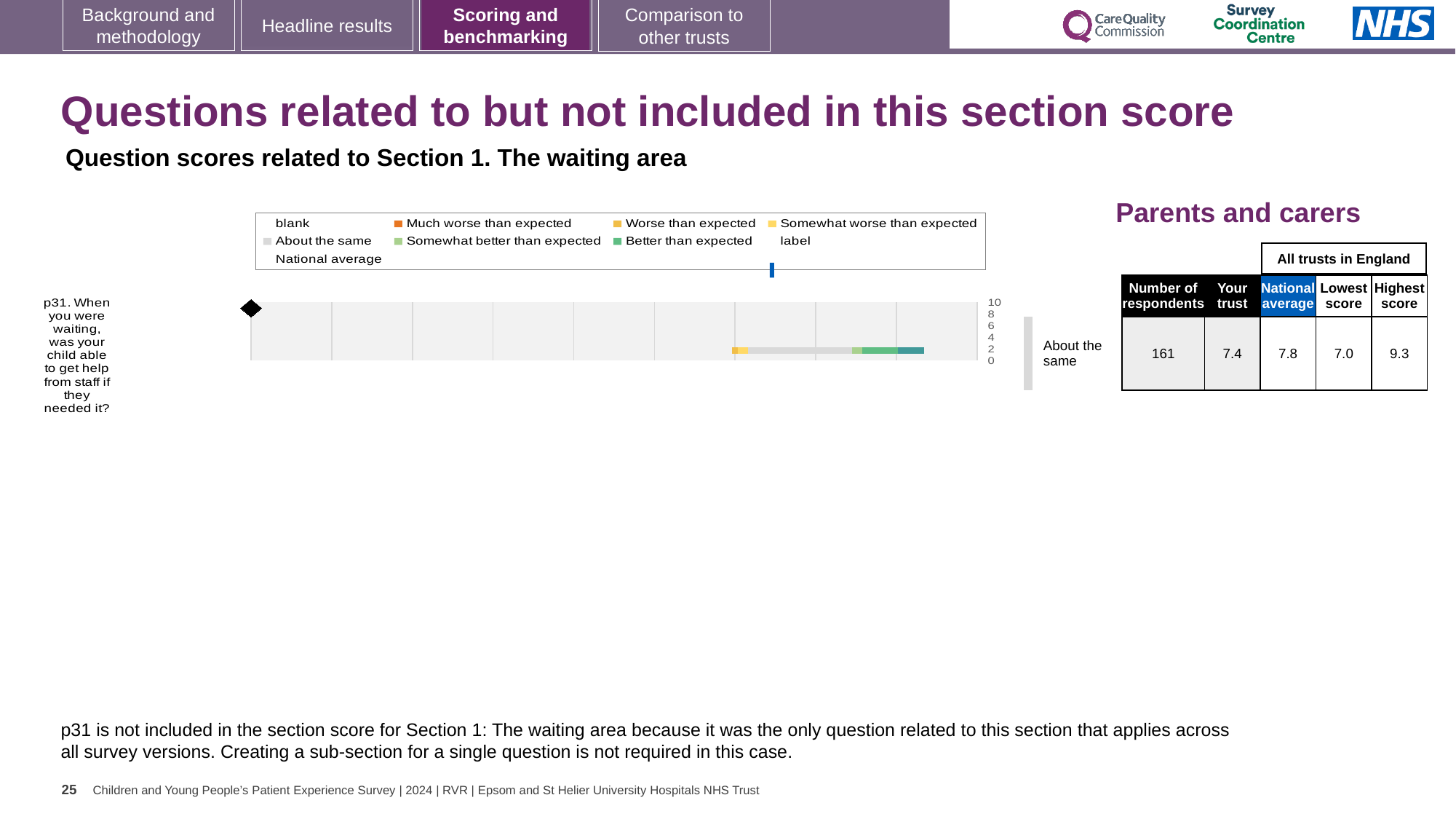
Which section do the question scores in the chart relate to? Section 1. The waiting area What is the difference between the highest and lowest trust scores for p31? 2.3 What is the national average score for p31 in the table beside the chart? 7.8 What is the 'Your trust' score for p31 in the table beside the chart? 7.4 What benchmark category is shown next to the bar for p31? About the same Which is larger for p31: the 'Your trust' score or the national average? National average What is the difference between the national average and the 'Your trust' score for p31? 0.4 How many respondents answered p31 according to the table beside the chart? 161 What is the lowest score among all trusts in England for p31? 7.0 What kind of chart is shown for question p31? bar chart How many questions are plotted in the chart? 1 What is the highest score among all trusts in England for p31? 9.3